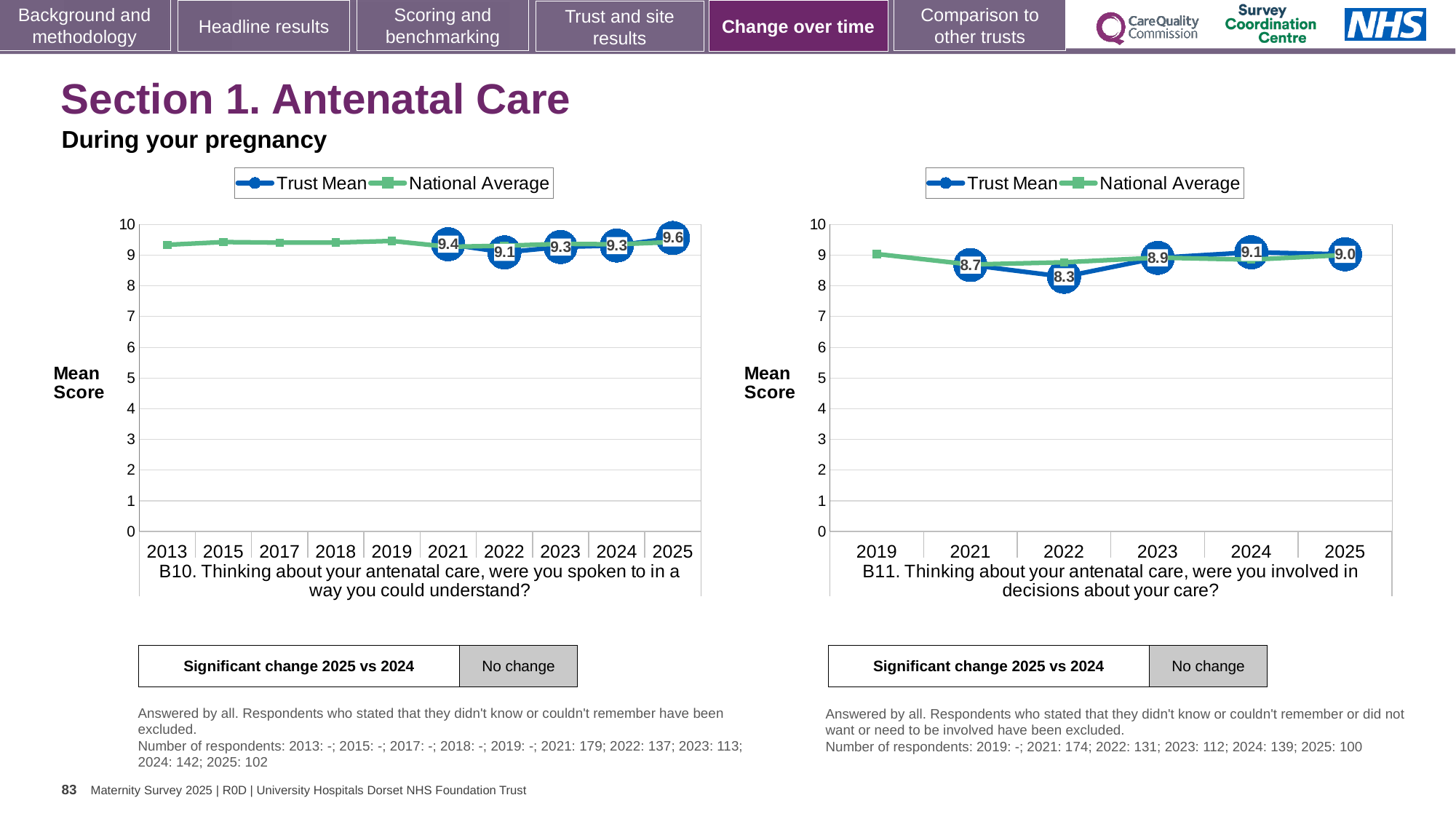
In the B11 chart on the right, which year has the lowest Trust Mean? 2022 In the B10 chart on the left, what is the Trust Mean for 2022? 9.1 How many years are shown on the x axis of the B10 chart on the left? 10 In the B11 chart on the right, what is the Trust Mean for 2022? 8.3 In the B10 chart on the left, what is the difference between the Trust Mean for 2025 and the Trust Mean for 2022? 0.5 What kind of chart is the B10 chart on the left? Line chart In the B11 chart on the right, what is the difference between the Trust Mean for 2024 and the Trust Mean for 2022? 0.8 In the B11 chart on the right, what is the Trust Mean for 2024? 9.1 In the B10 chart on the left, what is the Trust Mean for 2025? 9.6 In the B10 chart on the left, which year has the highest Trust Mean? 2025 How many series does the legend of the B11 chart on the right list? 2 In the B11 chart on the right, is the Trust Mean higher in 2023 or in 2022? 2023